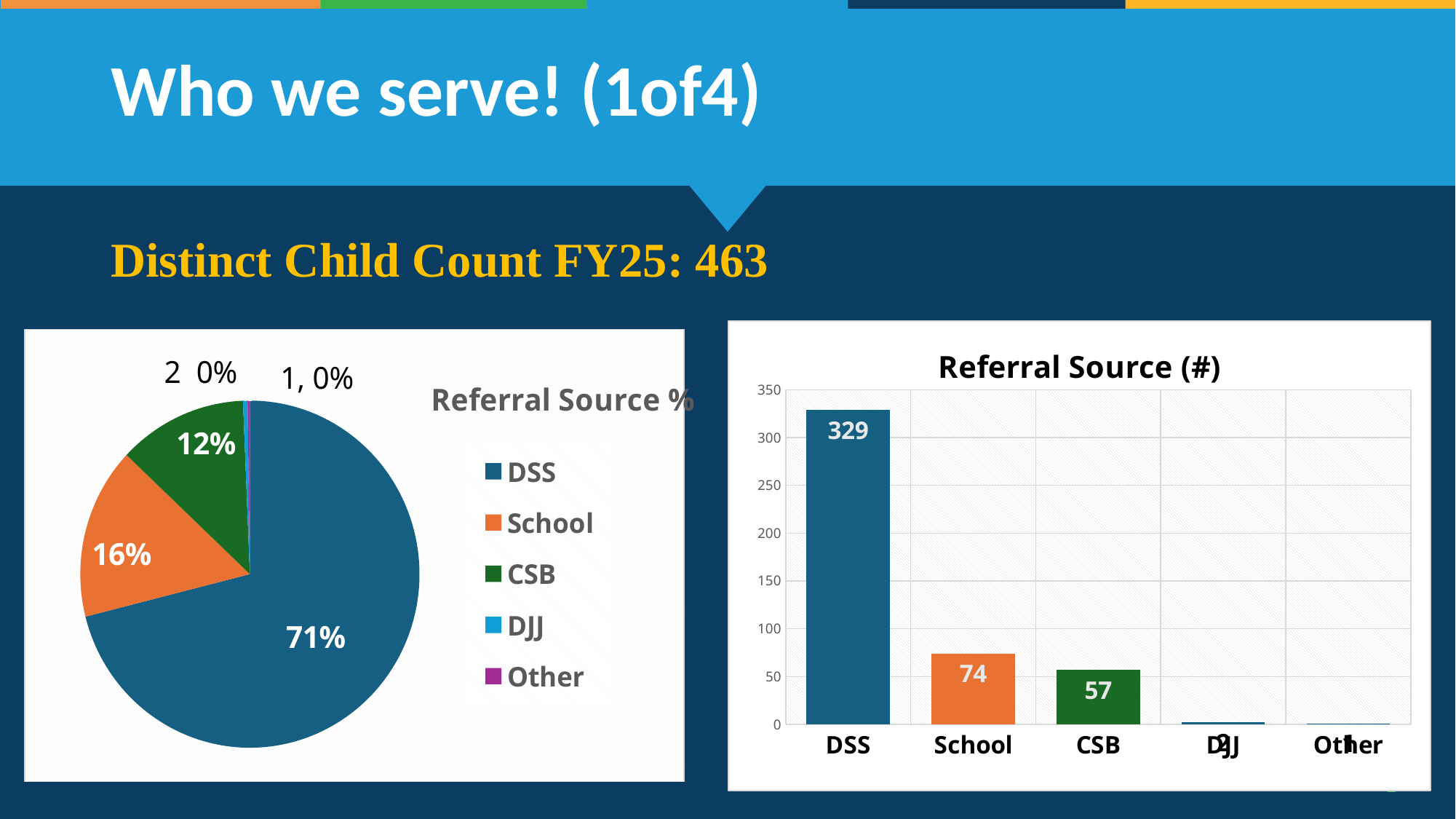
In the Referral Source (#) bar chart, what is the value for DSS? 329 How many entries does the legend of the Referral Source % pie chart list? 5 In the Referral Source (#) bar chart, what is the value for CSB? 57 In the Referral Source % pie chart, what share does DSS have? 71% In the Referral Source (#) bar chart, what is the value for School? 74 In the Referral Source % pie chart, which is larger, the CSB slice or the School slice? School What kind of chart is the Referral Source (#) chart on the right? bar chart In the Referral Source (#) bar chart, is the value for DSS greater or less than 300? greater In the Referral Source (#) bar chart, what is the difference between the DSS and School values? 255 In the Referral Source (#) bar chart, how many categories are shown on the x axis? 5 In the Referral Source (#) bar chart, which category has the highest value? DSS In the Referral Source % pie chart, what share does School have? 16%